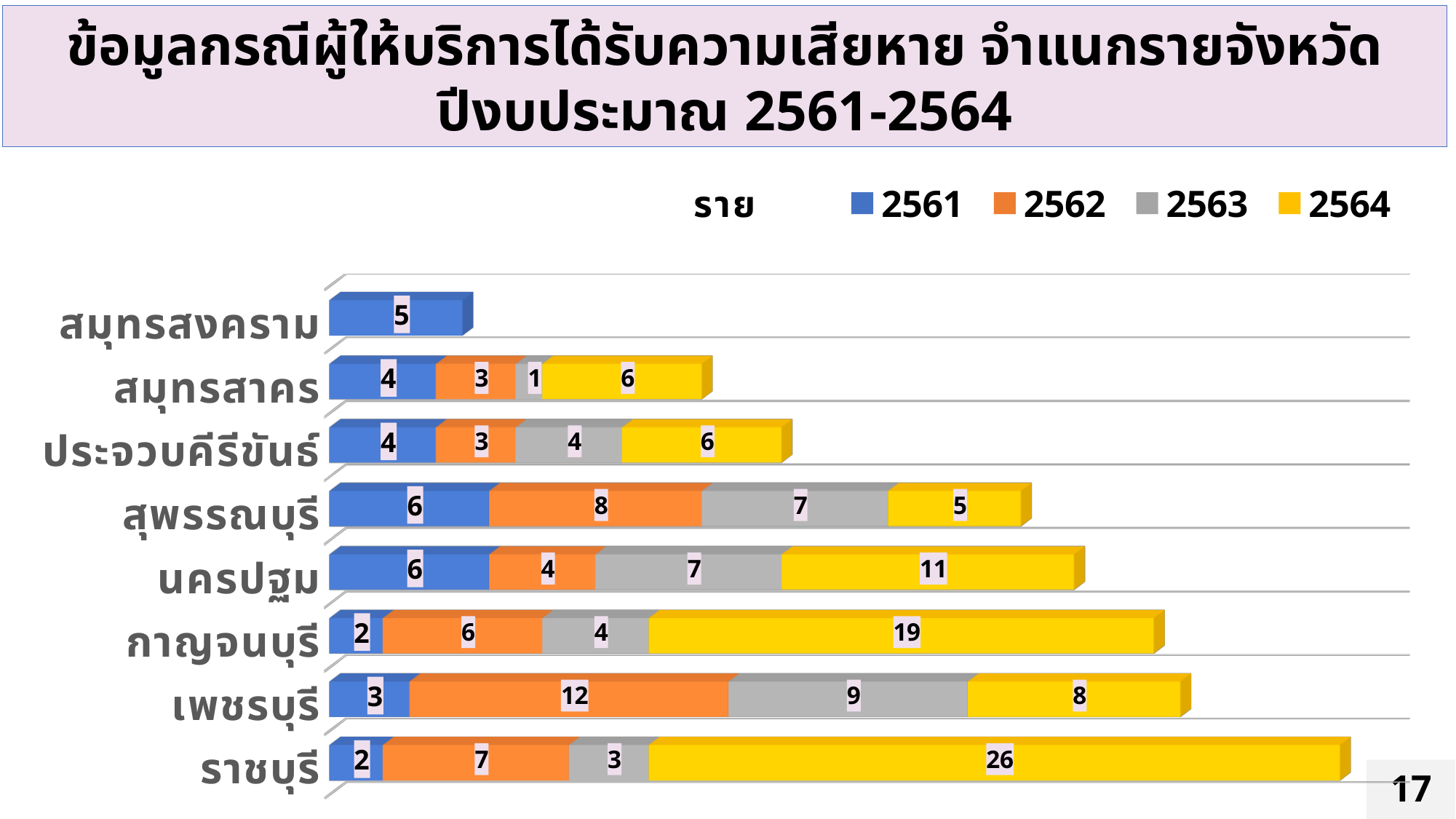
What is the total of the stacked bar for ราชบุรี? 38 What is the difference between the 2564 values for กาญจนบุรี and นครปฐม? 8 What is the total of the stacked bar for สุพรรณบุรี? 26 What kind of chart is shown on the slide? Stacked bar chart How many series does the legend list? 4 What is the value for ราชบุรี in 2564? 26 Which is larger: the 2562 value for เพชรบุรี or the 2562 value for สุพรรณบุรี? เพชรบุรี What is the value for เพชรบุรี in 2562? 12 How many provinces (categories) are shown on the chart? 8 Which province has the highest value in 2564? ราชบุรี What is the value for สมุทรสงคราม in 2561? 5 Which province has the lowest value in 2563 among those with a 2563 value? สมุทรสาคร